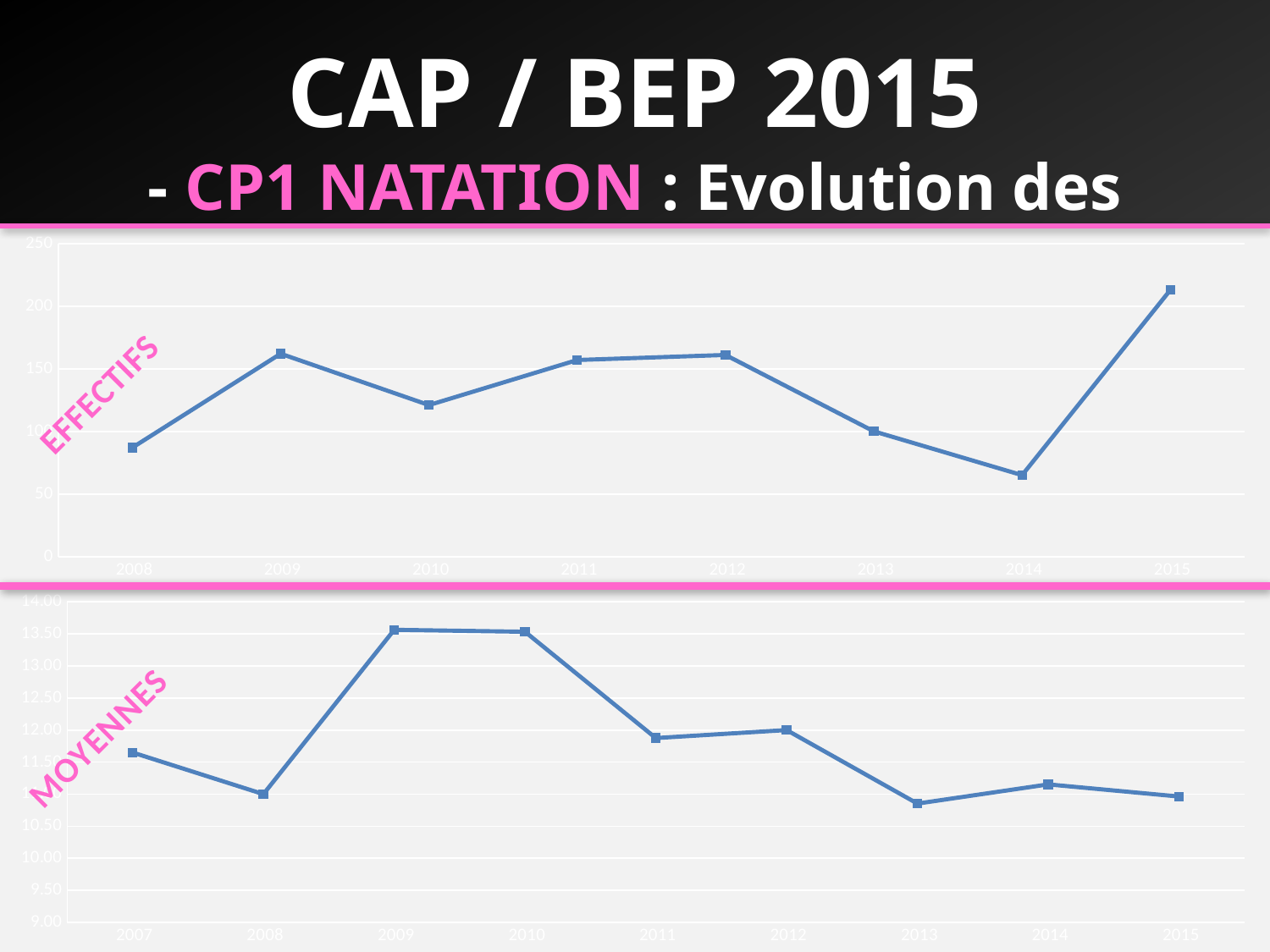
What is the pink label written beside the bottom chart? MOYENNES What type of chart is the top chart labelled EFFECTIFS? line chart In the bottom chart (MOYENNES), which is larger, the value for 2010 or the value for 2011? 2010 In the top chart (EFFECTIFS), which year has the lowest value? 2014 In the bottom chart (MOYENNES), is the value for 2009 greater or less than 13.00? greater How many years are plotted on the x axis of the bottom chart (MOYENNES)? 9 In the top chart (EFFECTIFS), which year has the highest value? 2015 In the top chart (EFFECTIFS), which is larger, the value for 2009 or the value for 2010? 2009 How many years are plotted on the x axis of the top chart (EFFECTIFS)? 8 In the top chart (EFFECTIFS), is the value for 2014 greater or less than 100? less In the top chart (EFFECTIFS), does the value rise or fall from 2014 to 2015? rise In the top chart (EFFECTIFS), is the value for 2015 greater or less than 200? greater